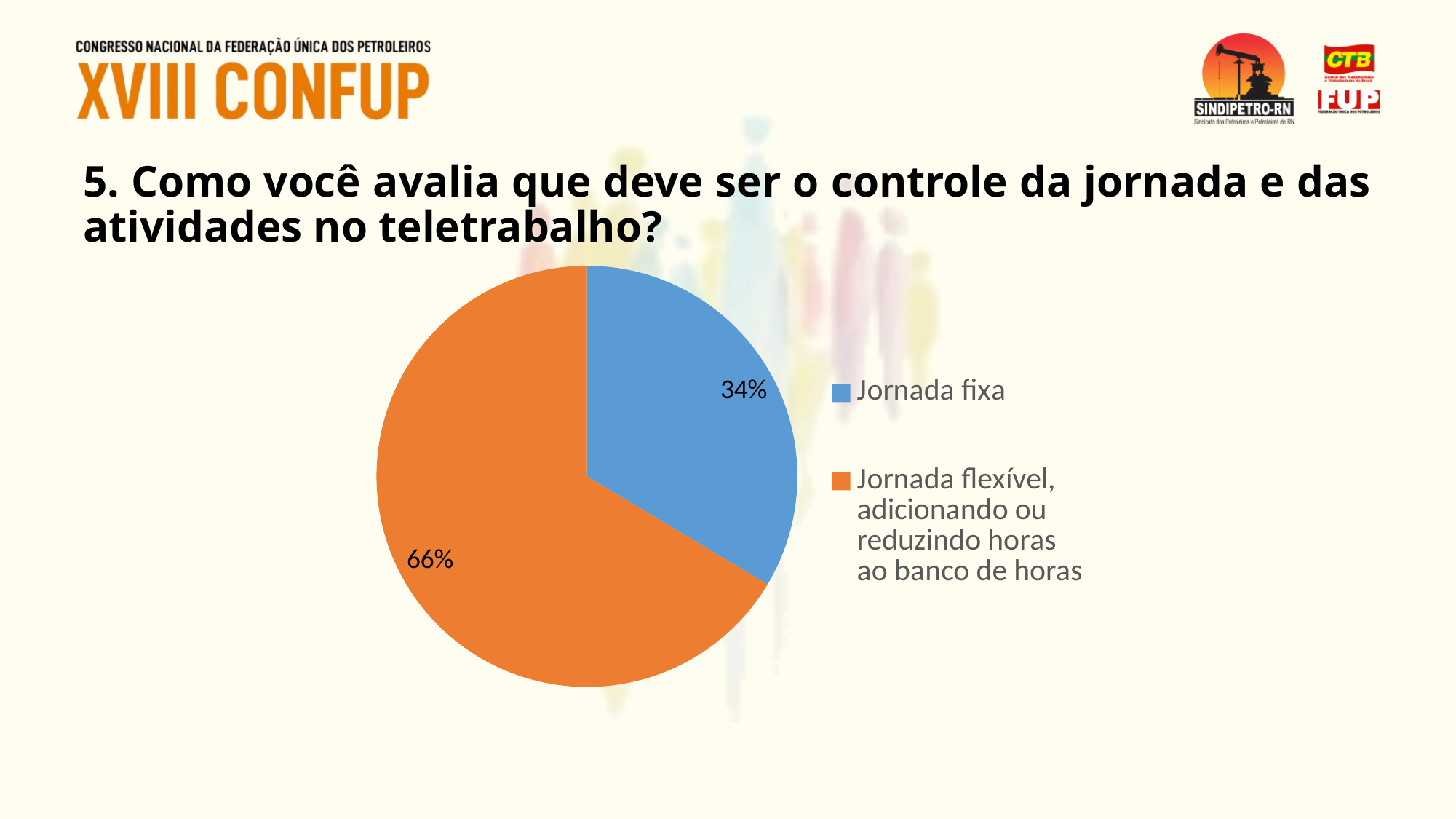
What colour is the slice for "Jornada fixa"? Blue Which category has the largest slice of the pie? Jornada flexível, adicionando ou reduzindo horas ao banco de horas What colour is the slice for "Jornada flexível, adicionando ou reduzindo horas ao banco de horas"? Orange What share of the pie does "Jornada flexível, adicionando ou reduzindo horas ao banco de horas" represent? 66% Which is larger: the slice for "Jornada fixa" or the slice for "Jornada flexível"? Jornada flexível How many categories does the pie chart have? 2 How many entries does the legend list? 2 What share of the pie does "Jornada fixa" represent? 34% What is the difference in percentage points between the "Jornada flexível" slice and the "Jornada fixa" slice? 32 What kind of chart is shown on the slide? Pie chart Which category has the smallest slice of the pie? Jornada fixa